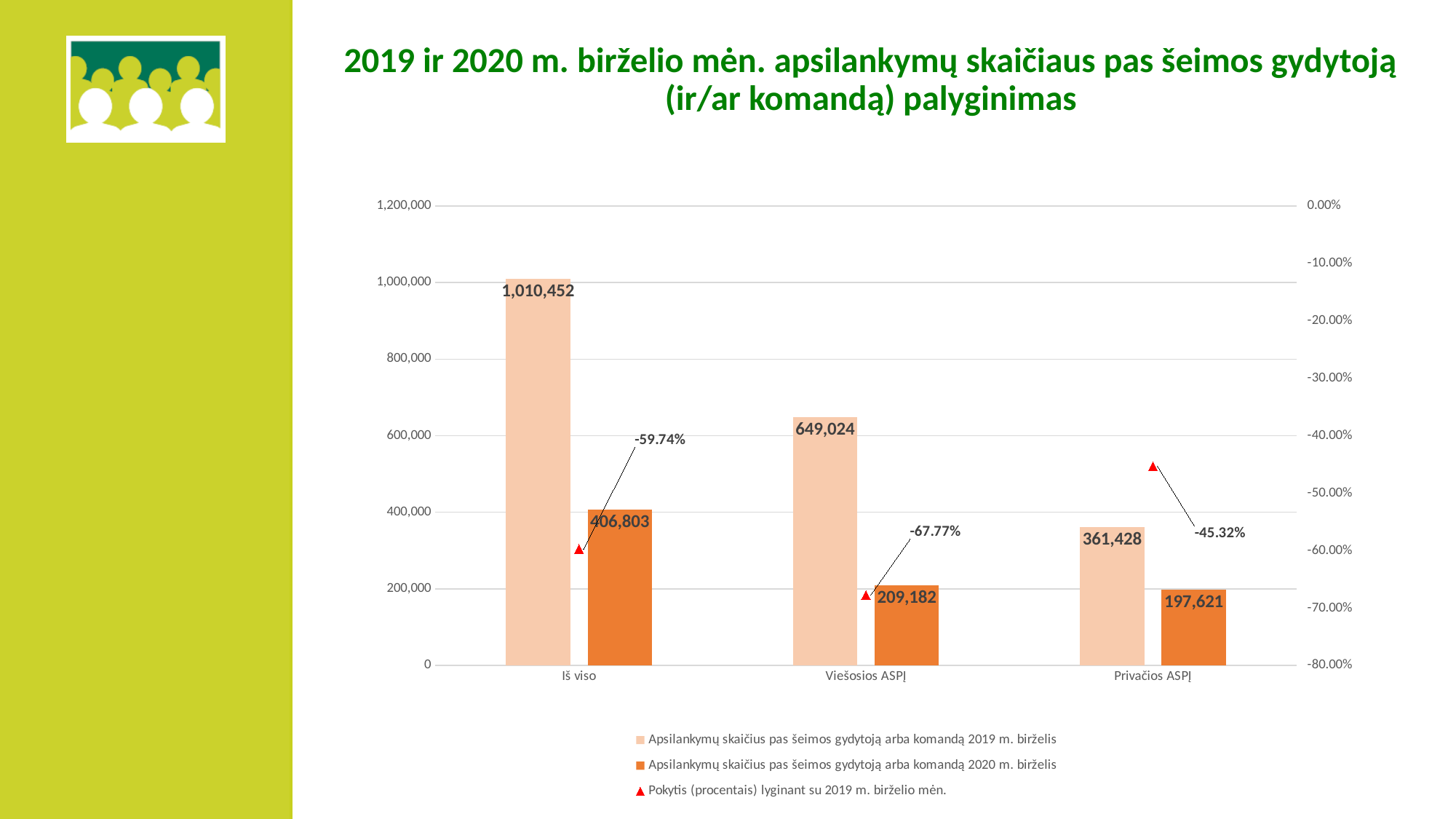
How many series does the legend list? 3 What is the number of visits in June 2019 for Privačios ASPĮ? 361,428 What is the difference between the June 2019 and June 2020 visit counts for Viešosios ASPĮ? 439,842 Which category has the lowest number of visits in June 2020? Privačios ASPĮ Which is larger: the June 2020 visit count for Iš viso or the June 2019 visit count for Privačios ASPĮ? June 2020 visit count for Iš viso What is the number of visits to a family doctor or team in June 2020 for Viešosios ASPĮ? 209,182 Which category has the largest percentage decrease (most negative Pokytis) compared with June 2019? Viešosios ASPĮ How many categories are shown on the x axis? 3 Which category has the highest number of visits in June 2019? Iš viso What kind of chart is used to show the visit counts? Bar chart What is the number of visits to a family doctor or team in June 2019 for Iš viso? 1,010,452 What is the percentage change (Pokytis) for Privačios ASPĮ compared with June 2019? -45.32%